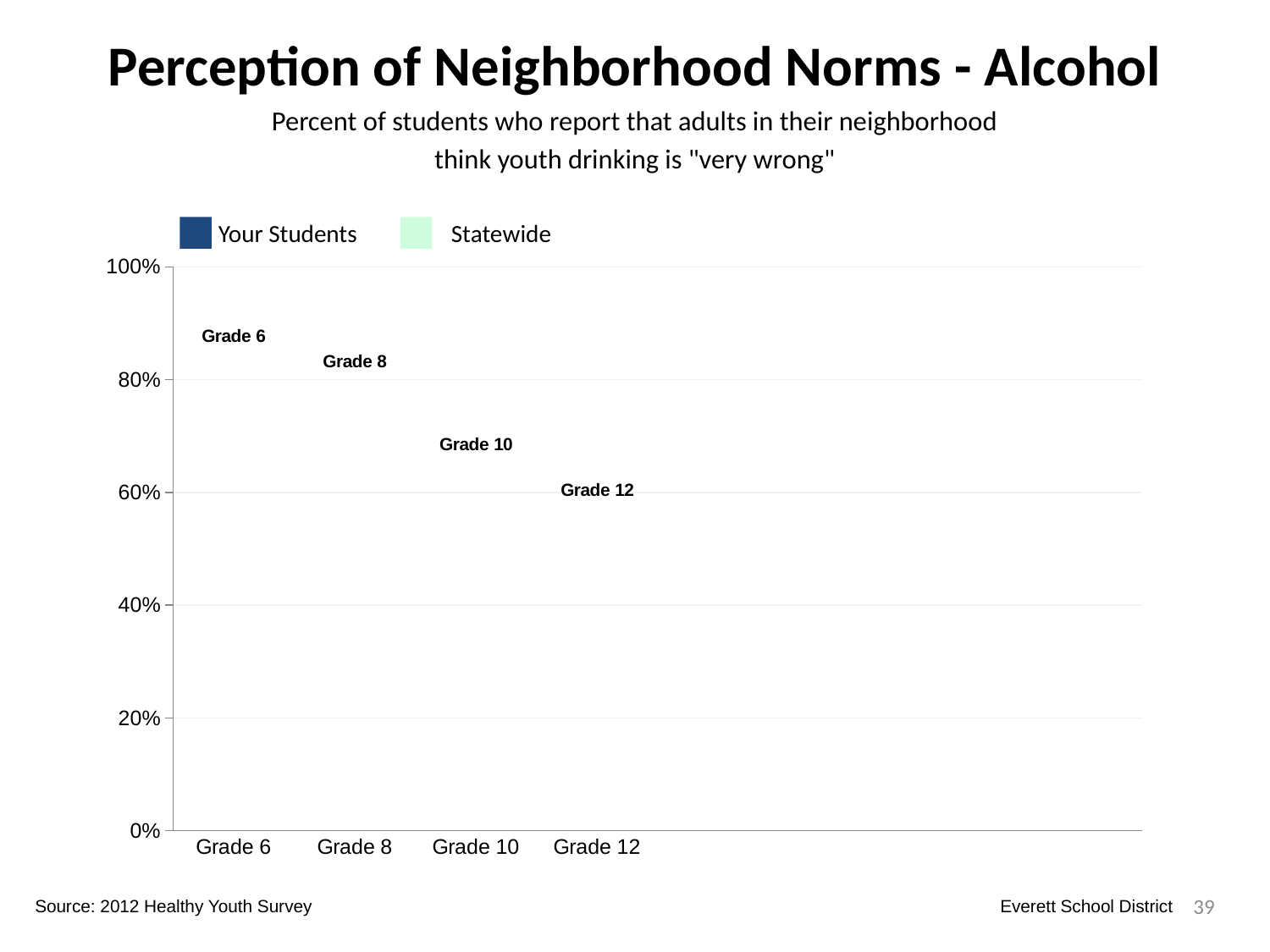
What are the two series named in the chart legend? Your Students and Statewide What is the source cited for the chart data? 2012 Healthy Youth Survey How many grade categories are shown on the x axis of the chart? 4 What is the highest value shown on the chart's y axis? 100% How many series does the chart legend list? 2 According to the chart subtitle, what do the percentages represent? Percent of students who report that adults in their neighborhood think youth drinking is "very wrong" Which grade categories appear on the x axis of the chart? Grade 6, Grade 8, Grade 10, Grade 12 What is the title of the slide containing the chart? Perception of Neighborhood Norms - Alcohol